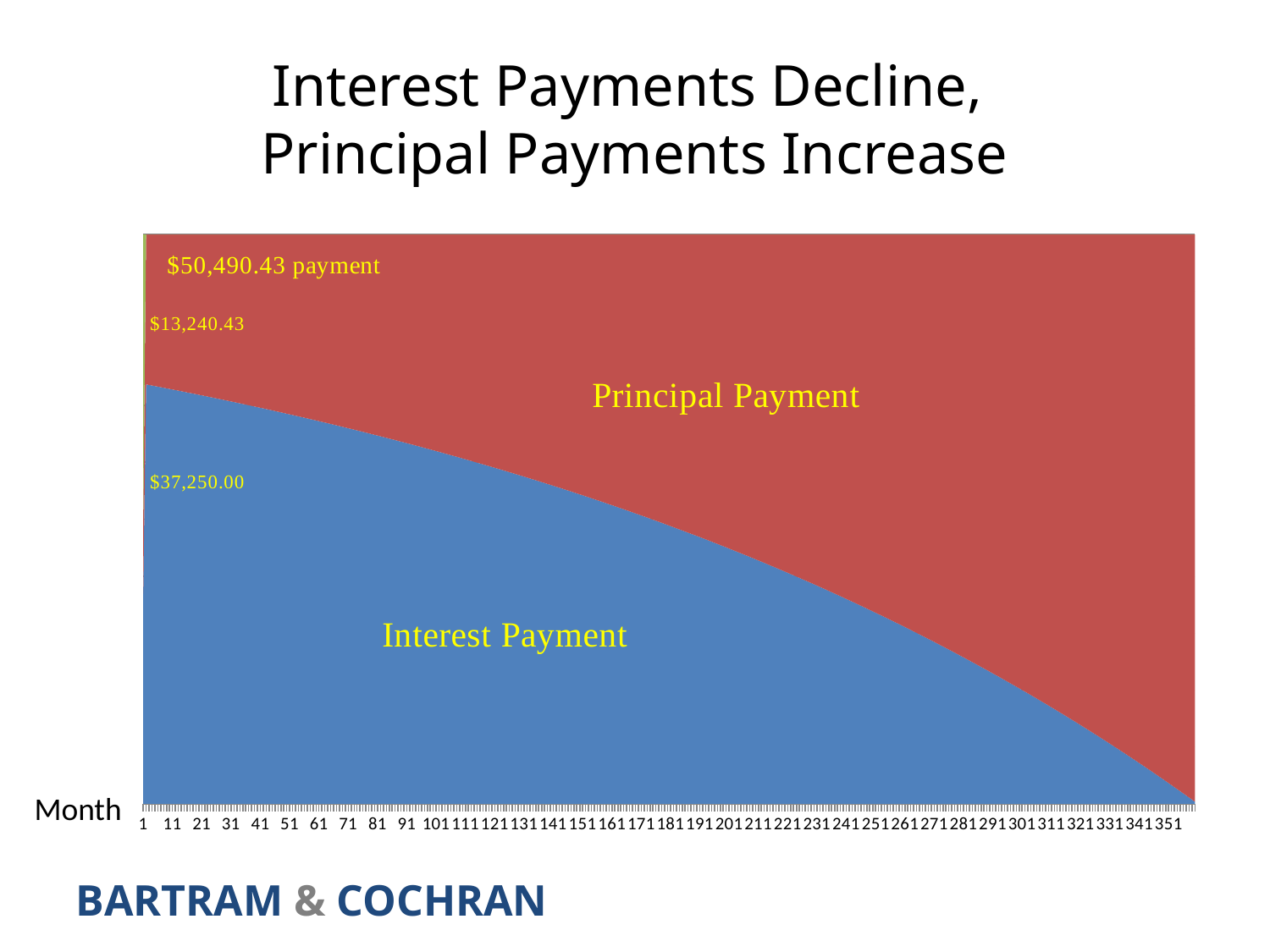
Does the Interest Payment rise or fall as the month increases along the x axis? fall Does the Principal Payment rise or fall as the month increases along the x axis? rise What is the title of the chart on the slide? Interest Payments Decline, Principal Payments Increase What is the label of the x axis? Month How many series are plotted in the chart? 2 What is the Principal Payment value labelled at the start of the chart? $13,240.43 What is the total of the labelled Interest Payment and Principal Payment values at the start of the chart? $50,490.43 What kind of chart is shown on the slide? area chart At the start of the chart, which is larger, the Interest Payment or the Principal Payment? Interest Payment What is the difference between the labelled Interest Payment ($37,250.00) and Principal Payment ($13,240.43) values? $24,009.57 What is the Interest Payment value labelled at the start of the chart? $37,250.00 What total payment amount is labelled on the chart? $50,490.43